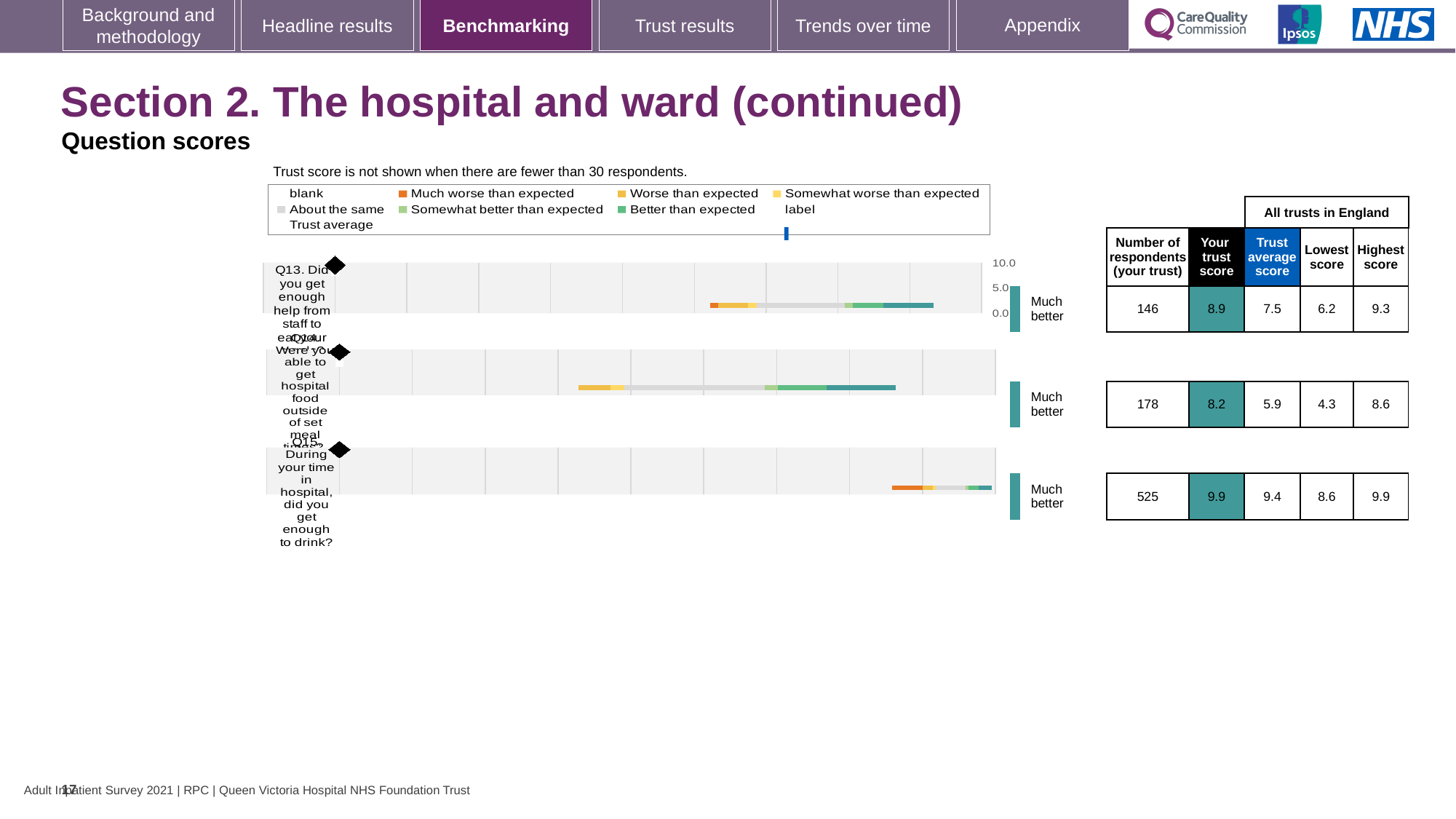
For Q13, how much higher is 'Your trust score' than the 'Trust average score'? 1.4 What is the 'Your trust score' for Q13 (Did you get enough help from staff to eat your meals?)? 8.9 How many questions are plotted in the chart? 3 How many respondents from your trust answered Q15 (did you get enough to drink?)? 525 According to the note above the chart, when is the trust score not shown? When there are fewer than 30 respondents What kind of chart is used to show the question scores on this slide? bar chart Which question has the highest 'Your trust score'? Q15 For Q14, which is larger: 'Your trust score' or the 'Trust average score'? Your trust score What is the 'Trust average score' for Q14 (Were you able to get hospital food outside of set meal times?)? 5.9 Which question has the lowest 'Trust average score'? Q14 What is the 'Lowest score' across all trusts in England for Q13? 6.2 What is the 'Highest score' across all trusts in England for Q14? 8.6